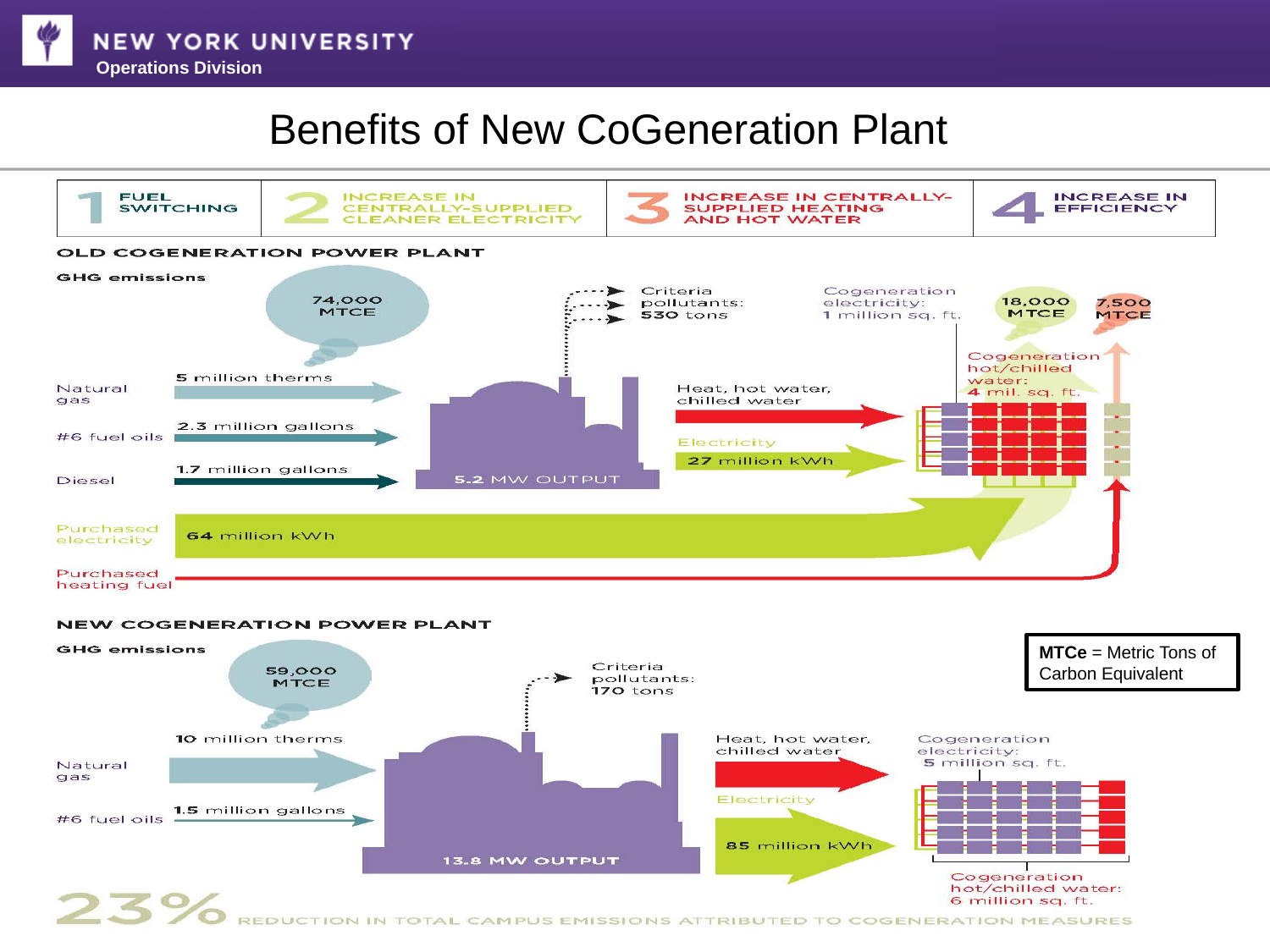
In the Old Cogeneration Power Plant diagram, what are the GHG emissions shown? 74,000 MTCE What percentage reduction in total campus emissions attributed to cogeneration measures is shown at the bottom of the slide? 23% Which plant uses more natural gas: the old plant (5 million therms) or the new plant (10 million therms)? New plant What is the MW output of the new cogeneration power plant? 13.8 MW In the Old Cogeneration Power Plant diagram, how much purchased electricity is shown? 64 million kWh In the New Cogeneration Power Plant diagram, how many tons of criteria pollutants are shown? 170 tons In the Old Cogeneration Power Plant diagram, how many tons of criteria pollutants are shown? 530 tons How much electricity does the new plant produce compared with the old plant's 27 million kWh? 85 million kWh In the New Cogeneration Power Plant diagram, what are the GHG emissions shown? 59,000 MTCE What is the MW output of the old cogeneration power plant? 5.2 MW How many numbered benefit categories are listed across the top of the infographic? 4 By how much do GHG emissions fall from the old plant (74,000 MTCE) to the new plant (59,000 MTCE)? 15,000 MTCE